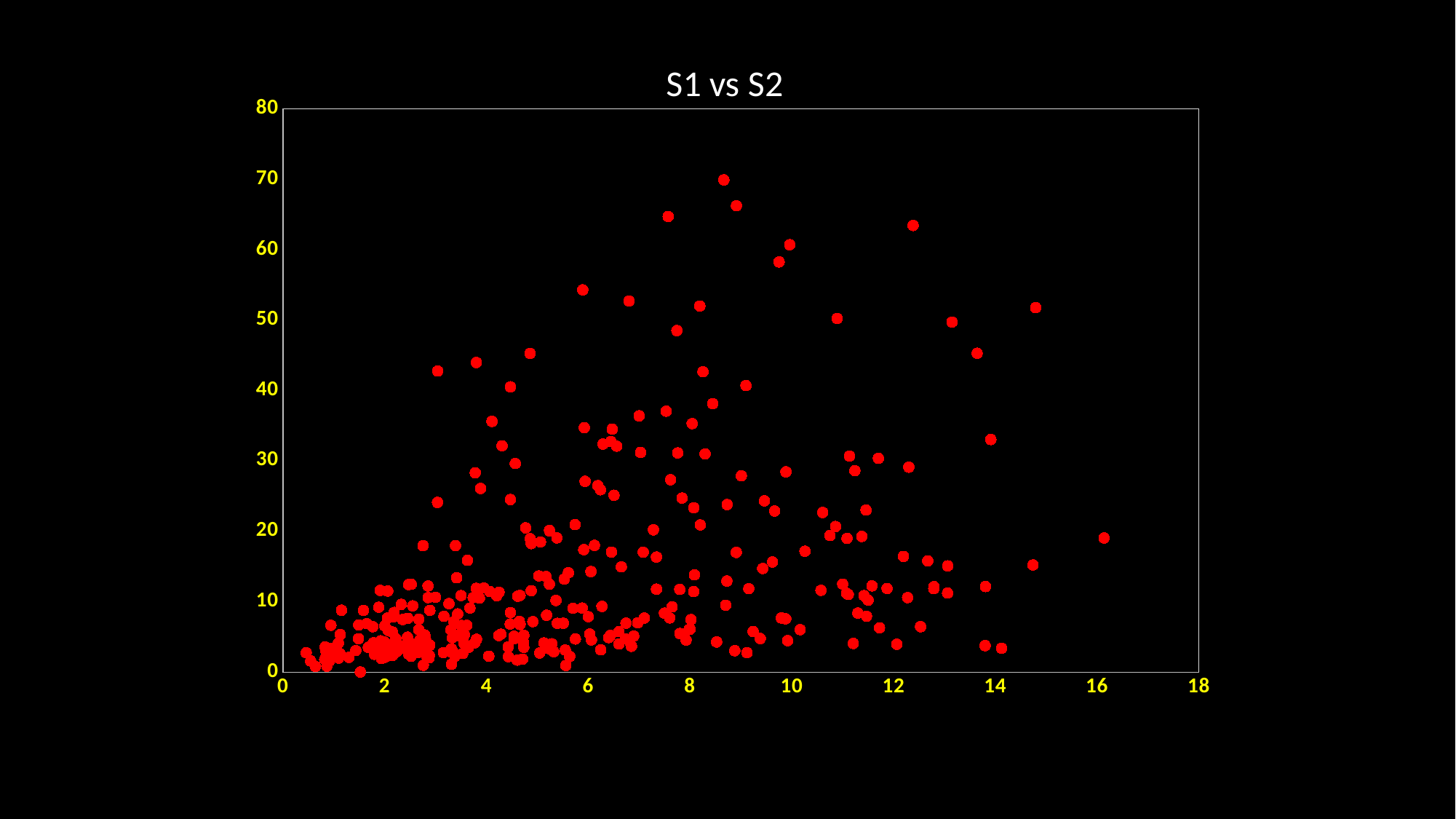
What is the maximum value shown on the y axis? 80 What colour are the data points in the chart? red What is the title of the chart? S1 vs S2 Is the y value of the rightmost point in the chart greater or less than 30? less Is the y value of the highest point in the chart greater or less than 60? greater Is the x value of the highest point in the chart greater or less than 6? greater What kind of chart is shown on the slide? scatter plot